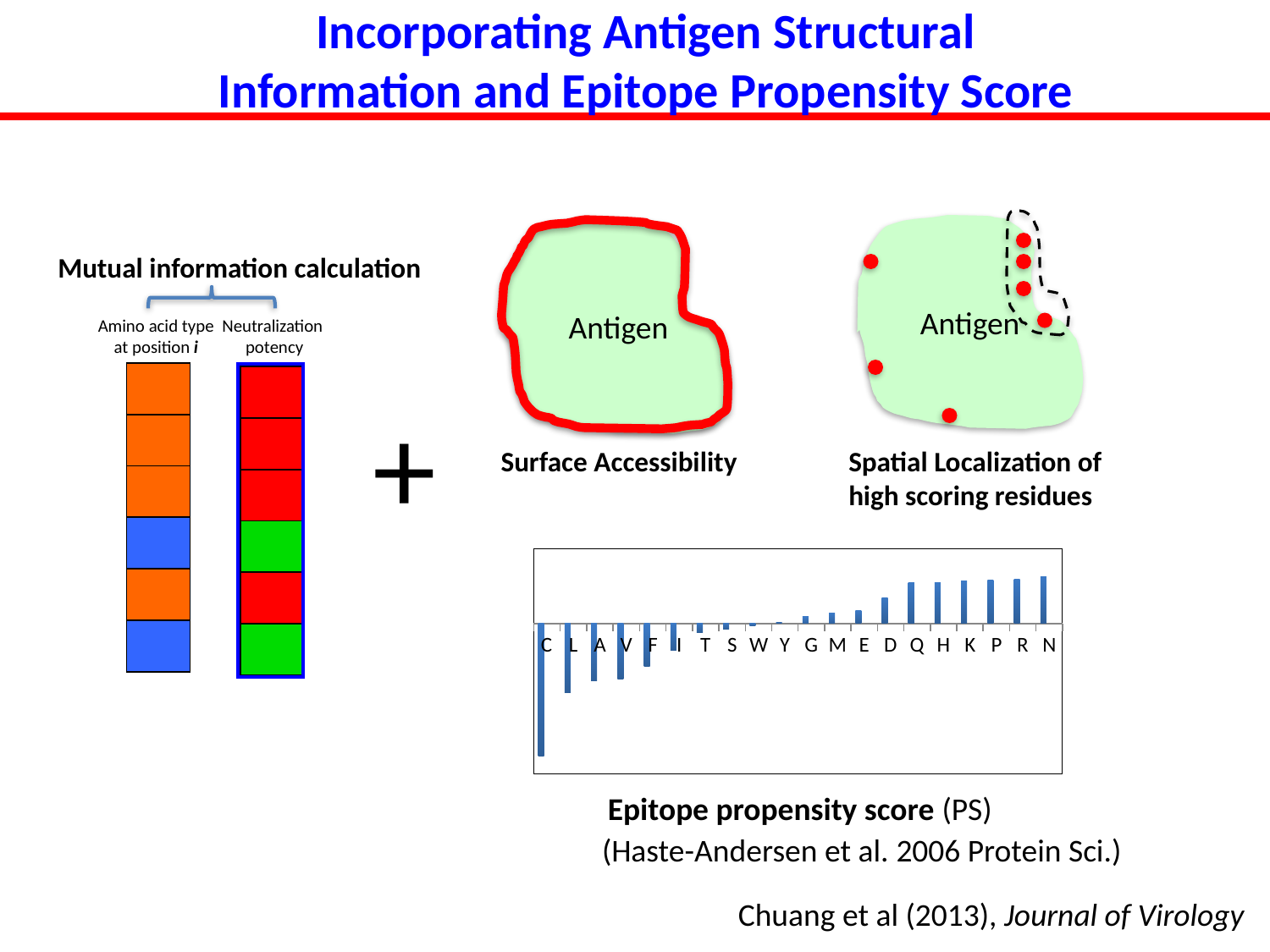
Which amino acid is the first category on the x axis of the epitope propensity score chart? C In the epitope propensity score chart, which has the larger value, C or N? N What kind of chart is shown at the bottom right of the slide? bar chart In the epitope propensity score chart, which amino acid has the lowest value? C How many amino acid categories are plotted on the x axis of the epitope propensity score chart? 20 In the epitope propensity score chart, do the values rise or fall moving from left to right along the x axis? rise What score does the bar chart at the bottom right of the slide show, according to the caption beneath it? Epitope propensity score (PS) In the epitope propensity score chart, which has the larger value, D or Q? Q In the epitope propensity score chart, which has the larger value, V or K? K